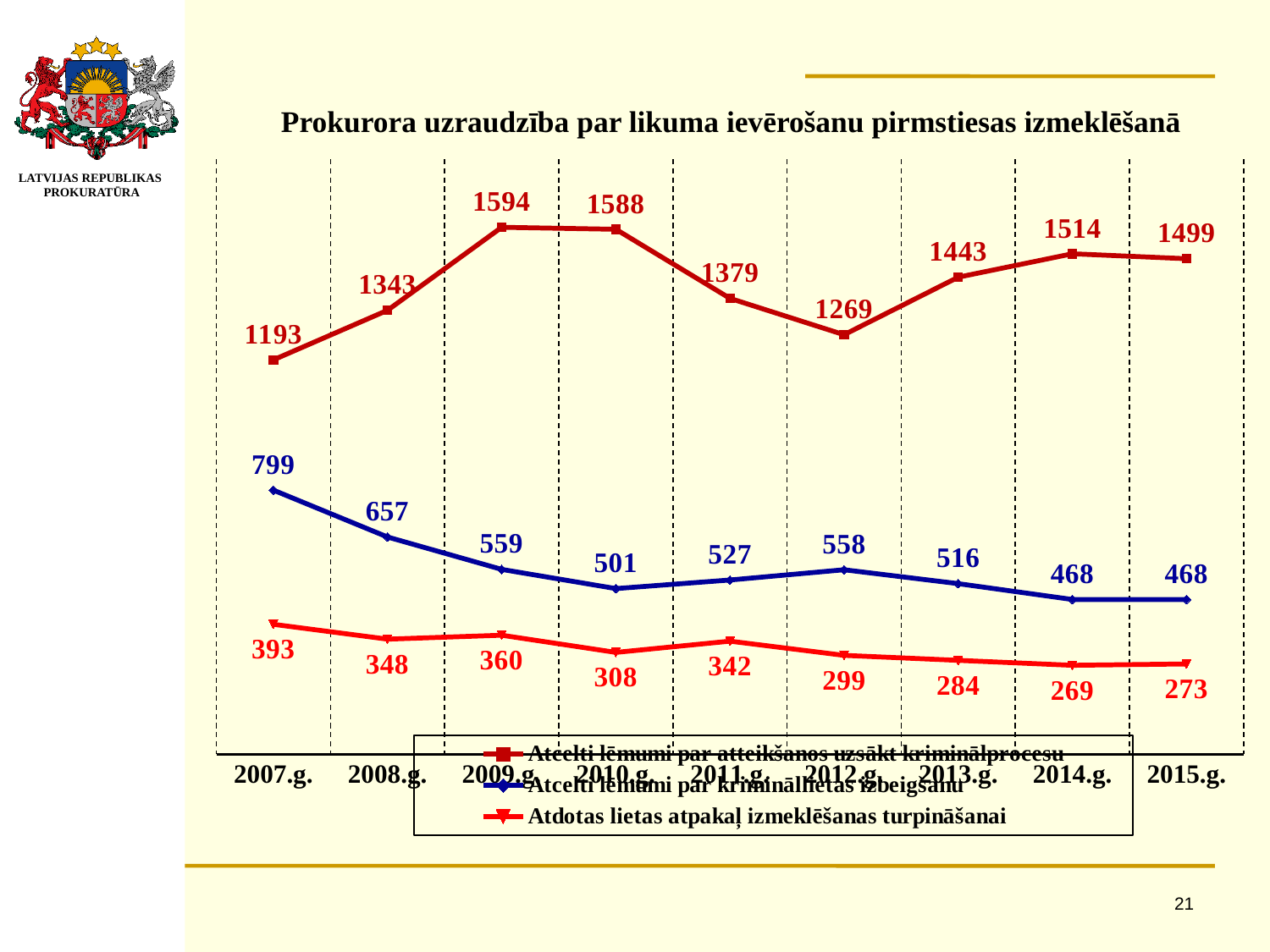
Which is larger for 'Atcelti lēmumi par krimināllietas izbeigšanu': the value in 2011.g. or in 2012.g.? 2012.g. What is the difference between the 2009.g. and 2007.g. values for 'Atcelti lēmumi par atteikšanos uzsākt kriminālprocesu'? 401 Does 'Atcelti lēmumi par krimināllietas izbeigšanu' generally rise or fall from 2007.g. to 2015.g.? fall What is the value for 'Atcelti lēmumi par atteikšanos uzsākt kriminālprocesu' in 2009.g.? 1594 In which year is 'Atdotas lietas atpakaļ izmeklēšanas turpināšanai' lowest? 2014.g. How many series does the legend list? 3 What type of chart is shown on the slide? line chart What is the title of the chart? Prokurora uzraudzība par likuma ievērošanu pirmstiesas izmeklēšanā In which year is 'Atcelti lēmumi par atteikšanos uzsākt kriminālprocesu' lowest? 2007.g. What is the value for 'Atdotas lietas atpakaļ izmeklēšanas turpināšanai' in 2013.g.? 284 How many years are shown on the x axis? 9 What is the value for 'Atcelti lēmumi par krimināllietas izbeigšanu' in 2007.g.? 799